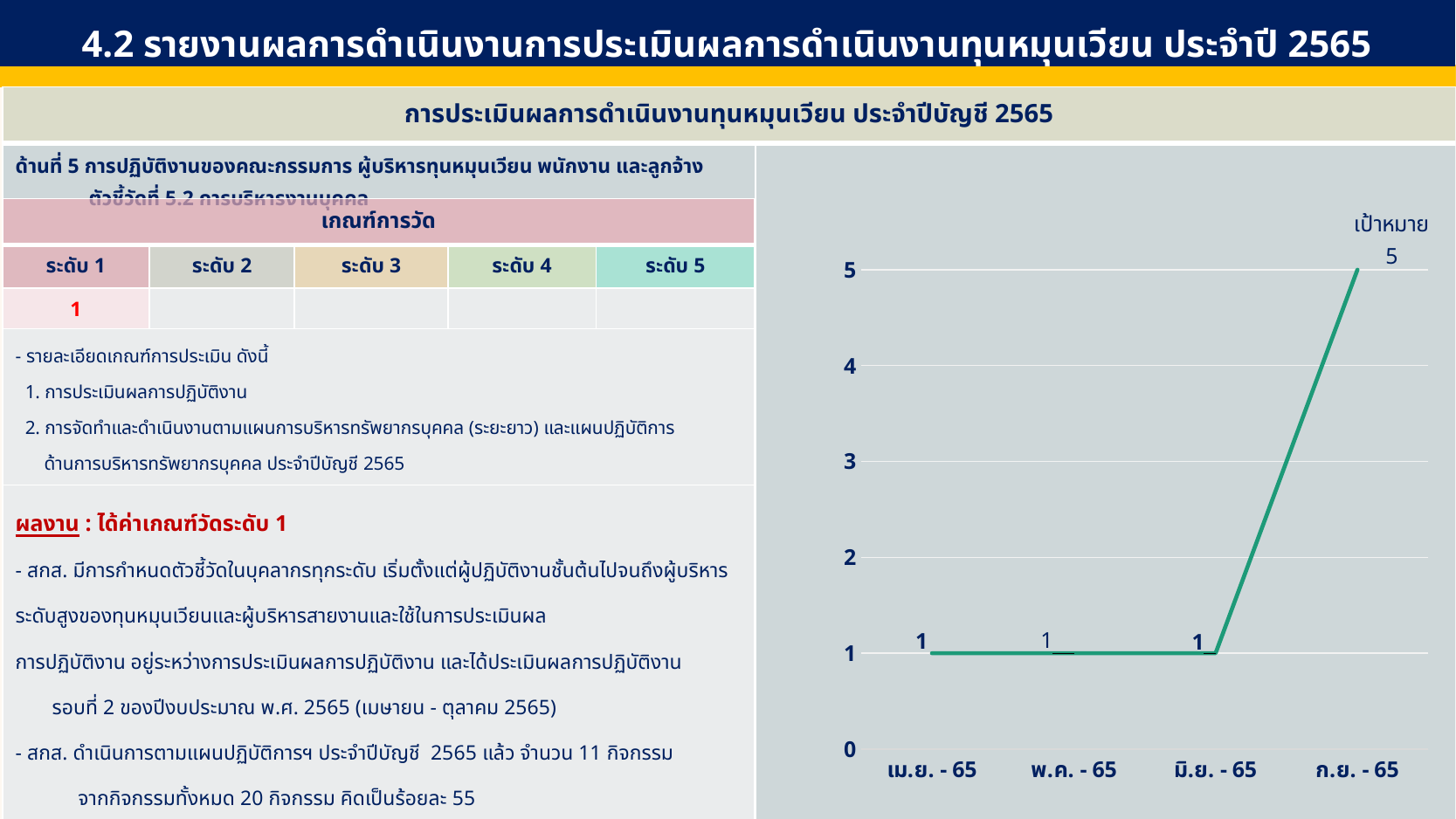
How many categories are shown on the x axis of the chart? 4 What is the difference between the value for ก.ย. - 65 and the value for มิ.ย. - 65? 4 What is the value plotted for มิ.ย. - 65? 1 Do the values rise or fall from มิ.ย. - 65 to ก.ย. - 65? rise What label is written above the last point of the line? เป้าหมาย What is the value plotted for ก.ย. - 65? 5 Is the value for ก.ย. - 65 greater or less than 3? greater What is the value plotted for เม.ย. - 65? 1 What kind of chart is shown on the right side of the slide? line chart Which is larger, the value for ก.ย. - 65 or the value for เม.ย. - 65? ก.ย. - 65 What is the value plotted for พ.ค. - 65? 1 Which category on the x axis has the highest value? ก.ย. - 65